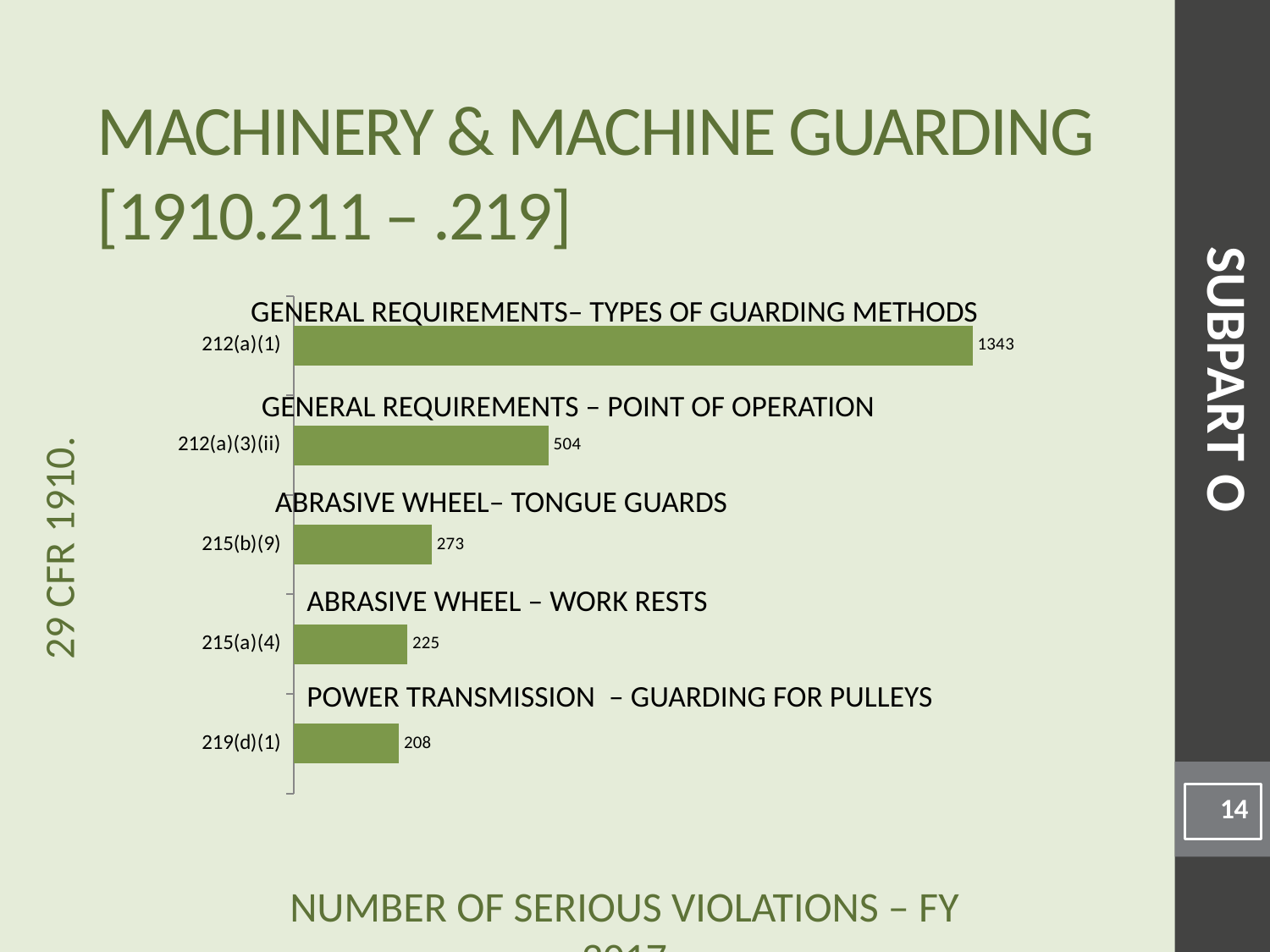
What is the number of serious violations for 212(a)(1)? 1343 What is the number of serious violations for 212(a)(3)(ii)? 504 What is the difference between the violations for 215(b)(9) and 215(a)(4)? 48 What is the difference between the violations for 212(a)(1) and 212(a)(3)(ii)? 839 Which standard has the highest number of serious violations? 212(a)(1) How many standards are shown in the chart? 5 What is the number of serious violations for 215(b)(9)? 273 What kind of chart is shown on the slide? Bar chart Which standard has the lowest number of serious violations? 219(d)(1) What is the number of serious violations for 219(d)(1)? 208 Which has more serious violations, 215(a)(4) or 219(d)(1)? 215(a)(4) What is the number of serious violations for 215(a)(4)? 225